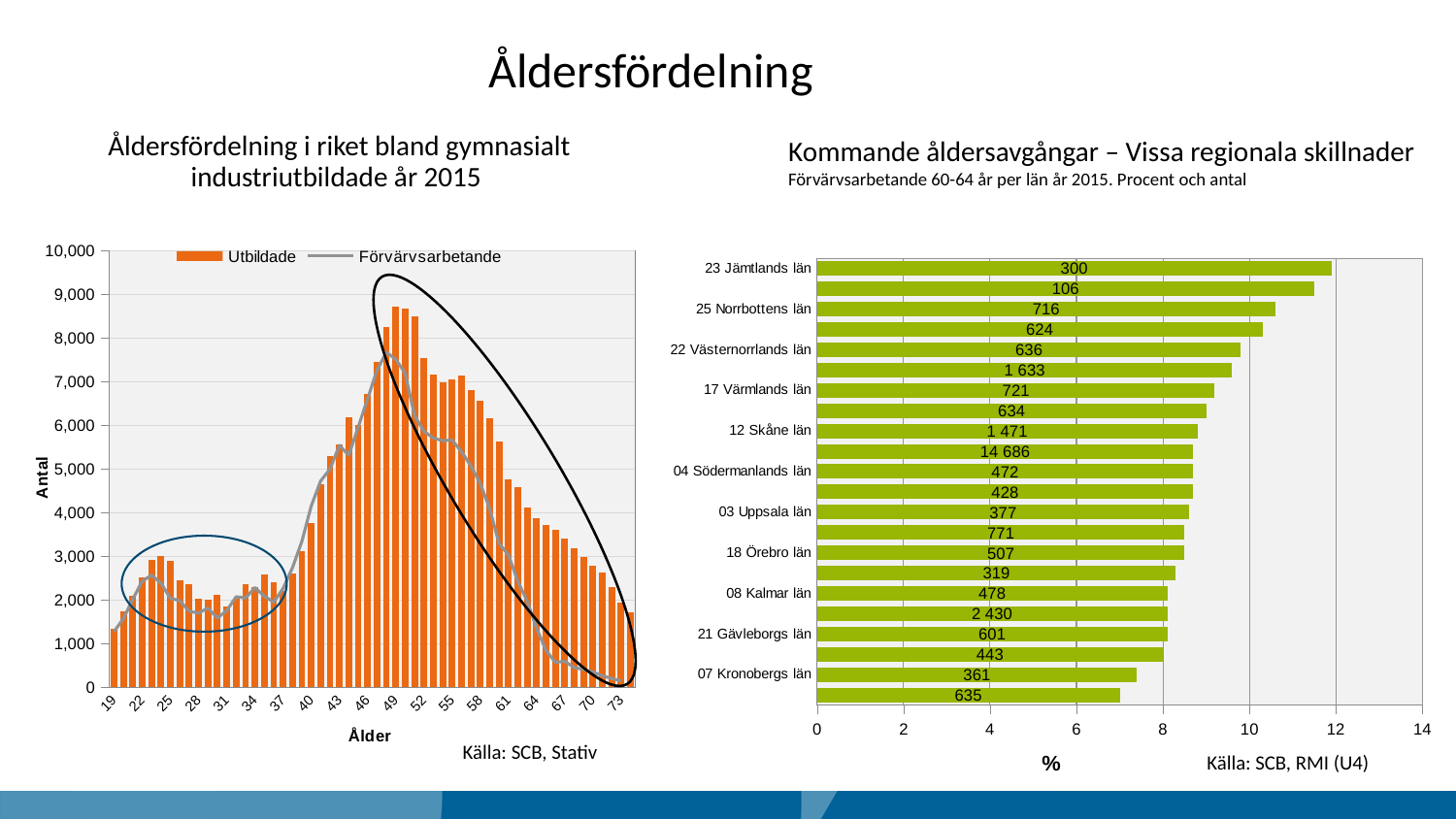
In the right-hand chart 'Kommande åldersavgångar', what number is printed on the bar for 08 Kalmar län? 478 In the left-hand chart 'Åldersfördelning i riket bland gymnasialt industriutbildade år 2015', is the Utbildade bar at age 49 greater or less than 8,000? greater In the right-hand chart 'Kommande åldersavgångar', what number is printed on the bar for 12 Skåne län? 1 471 What kind of chart is the right-hand chart titled 'Kommande åldersavgångar – Vissa regionala skillnader'? bar chart In the right-hand chart 'Kommande åldersavgångar', is the bar for 07 Kronobergs län greater or less than 8%? less How many series does the legend of the left-hand chart 'Åldersfördelning i riket bland gymnasialt industriutbildade år 2015' list? 2 In the right-hand chart 'Kommande åldersavgångar', what number is printed on the bar for 23 Jämtlands län? 300 What are the two legend entries in the left-hand chart 'Åldersfördelning i riket bland gymnasialt industriutbildade år 2015'? Utbildade and Förvärvsarbetande What is the x-axis title of the left-hand chart 'Åldersfördelning i riket bland gymnasialt industriutbildade år 2015'? Ålder In the right-hand chart 'Kommande åldersavgångar', which bar is longer: 25 Norrbottens län or 07 Kronobergs län? 25 Norrbottens län In the right-hand chart 'Kommande åldersavgångar', which labelled county has the longest bar? 23 Jämtlands län How many bars are plotted in the right-hand chart 'Kommande åldersavgångar'? 22